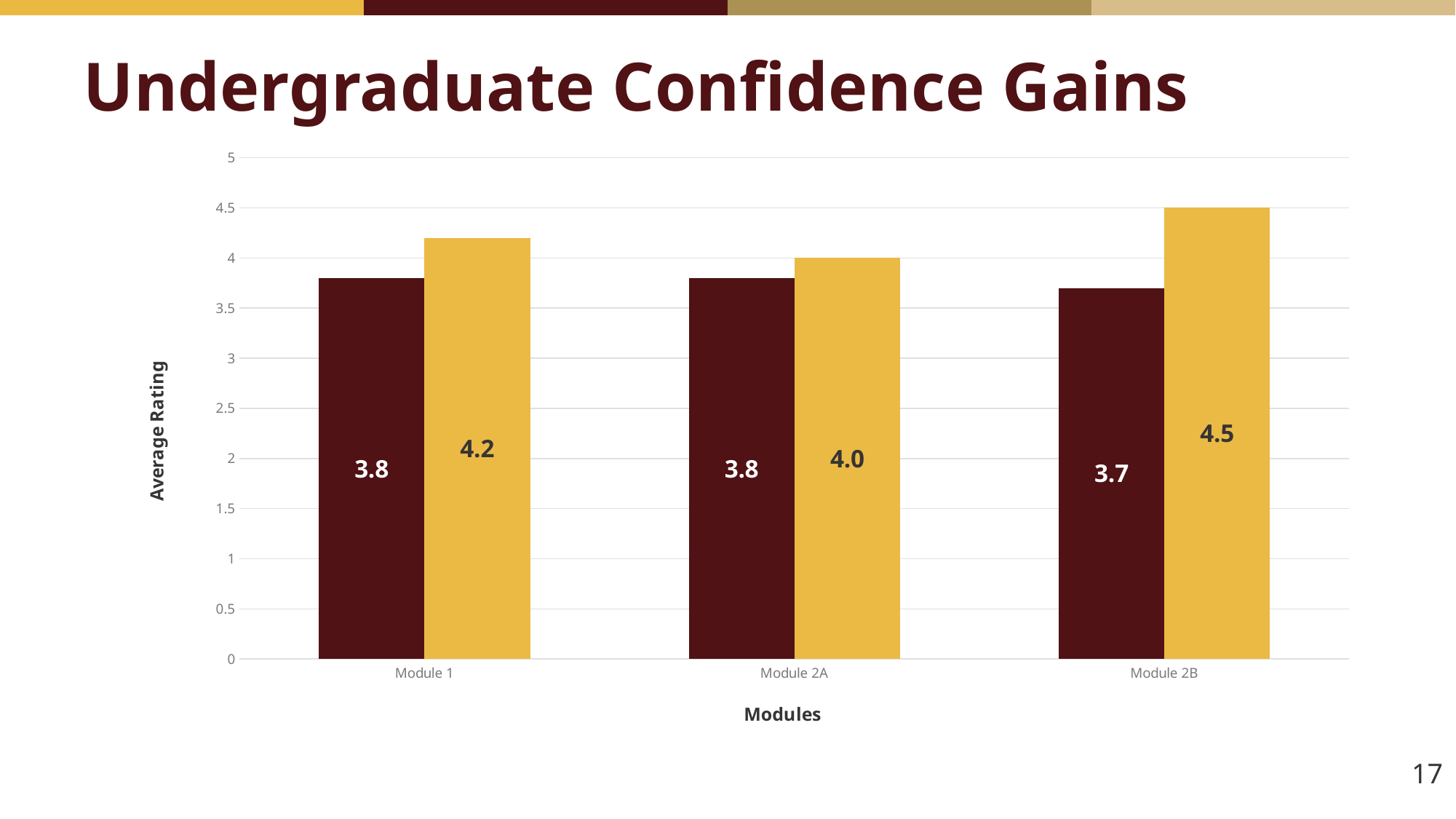
How many modules are shown on the x axis? 3 Which module has the highest gold bar? Module 2B What is the difference between the gold bar and the dark red bar for Module 2B? 0.8 Which is larger: the gold bar for Module 1 or the gold bar for Module 2A? Module 1 Which module has the lowest dark red bar? Module 2B What kind of chart is shown on the slide? Bar chart What is the value of the dark red bar for Module 2B? 3.7 What is the title of the vertical axis? Average Rating What is the value of the gold bar for Module 2B? 4.5 What is the value of the dark red bar for Module 1? 3.8 What is the difference between the gold bar and the dark red bar for Module 1? 0.4 What is the value of the gold bar for Module 2A? 4.0